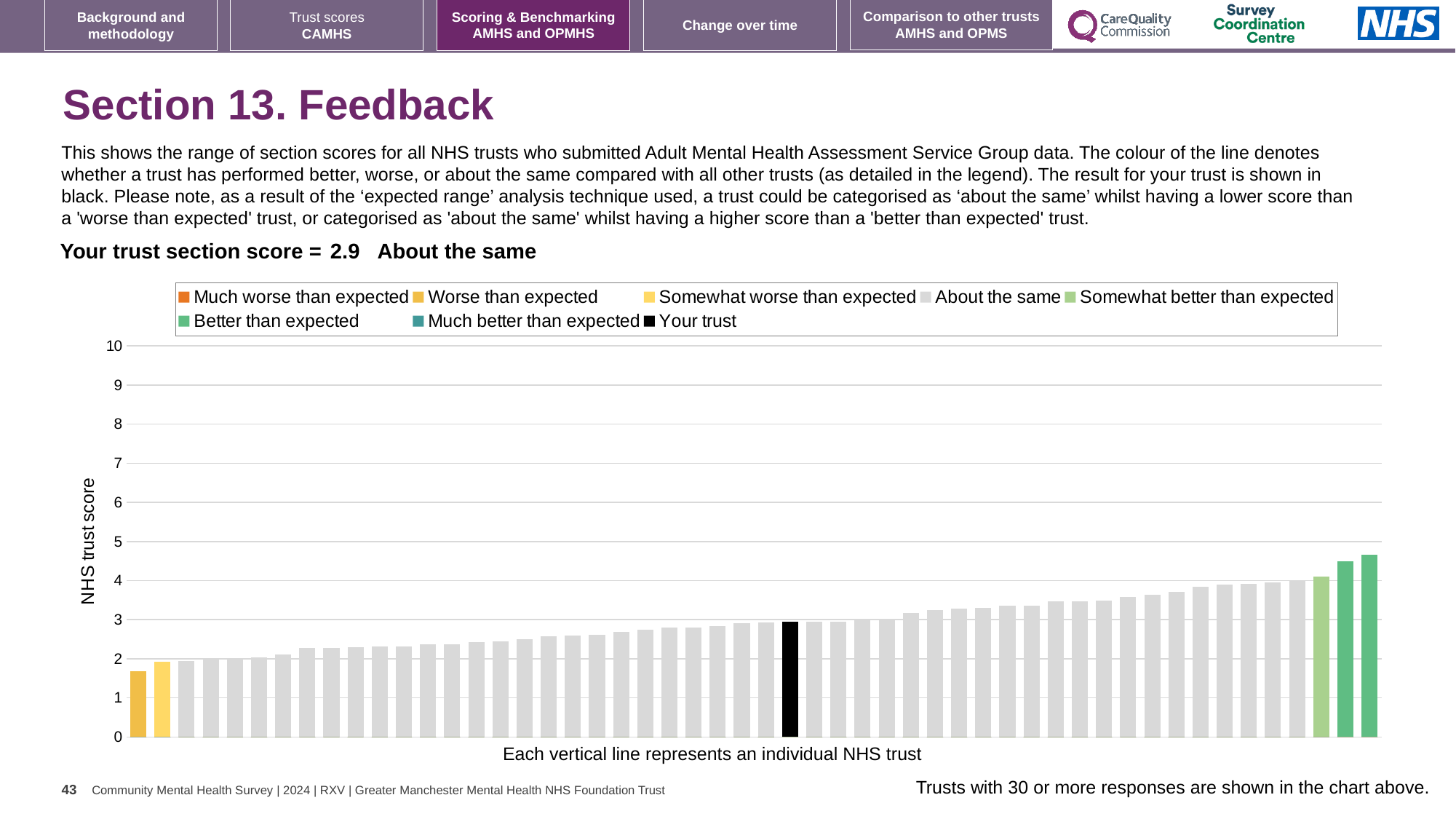
What is the title of the vertical axis? NHS trust score How many bars are coloured as 'Better than expected'? 2 Which legend category does your trust fall into? About the same Which legend category does the tallest bar belong to? Better than expected Which legend category does the shortest bar belong to? Worse than expected Is the value of the shortest bar greater or less than 2? less What kind of chart is shown on the slide? bar chart What is the section score for your trust shown on the slide? 2.9 Is the value for your trust's bar greater or less than 2? greater How many entries does the chart legend list? 8 Is the value of the tallest bar greater or less than 4? greater Do the bar values rise or fall from left to right along the x axis? rise